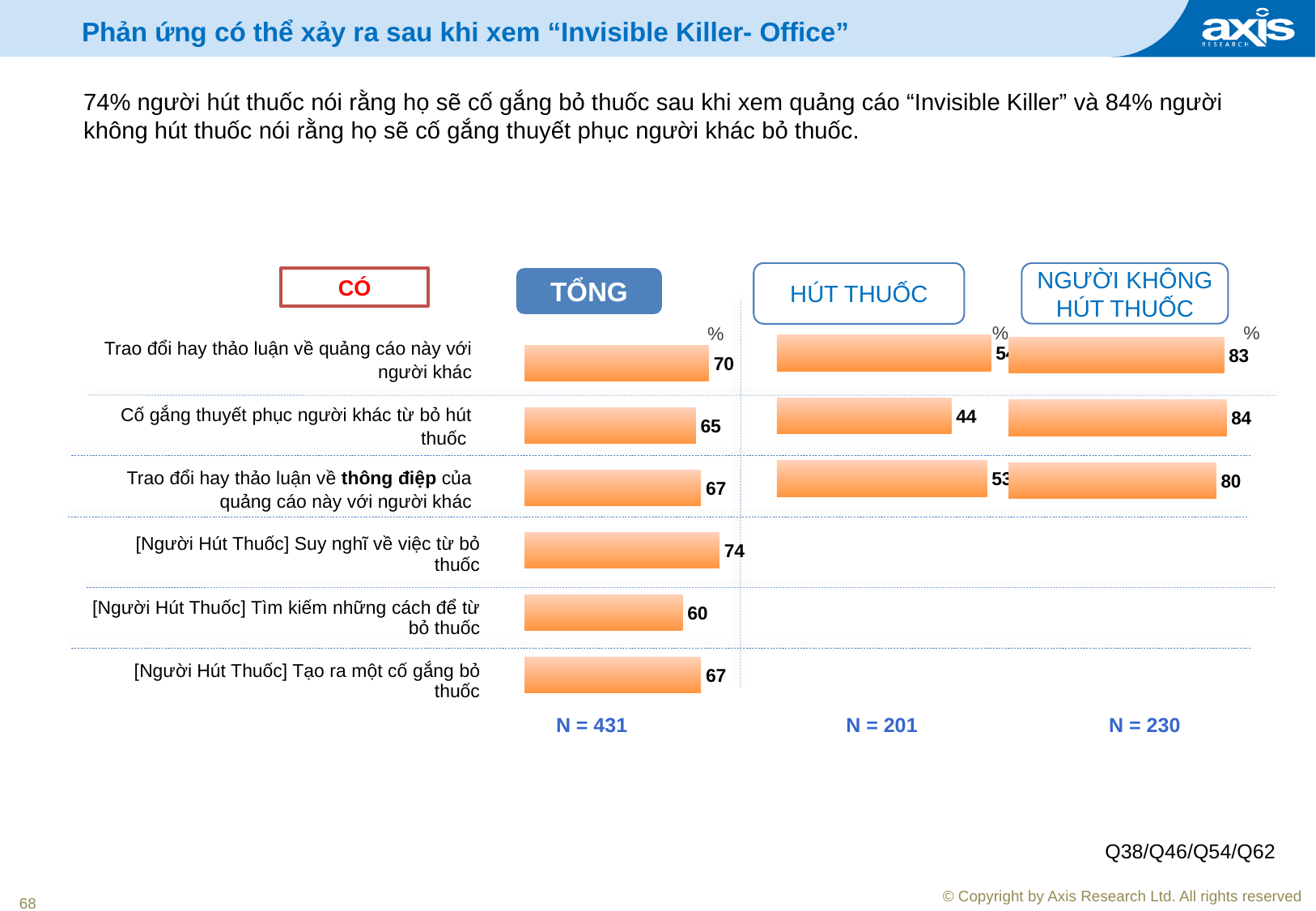
In the NGƯỜI KHÔNG HÚT THUỐC chart, which category has the highest value? Cố gắng thuyết phục người khác từ bỏ hút thuốc In the TỔNG chart, what is the value for "[Người Hút Thuốc] Suy nghĩ về việc từ bỏ thuốc"? 74 In the TỔNG chart, which category has the highest value? [Người Hút Thuốc] Suy nghĩ về việc từ bỏ thuốc For "Cố gắng thuyết phục người khác từ bỏ hút thuốc", which is larger: the HÚT THUỐC value or the NGƯỜI KHÔNG HÚT THUỐC value? NGƯỜI KHÔNG HÚT THUỐC What is the difference between the NGƯỜI KHÔNG HÚT THUỐC value and the HÚT THUỐC value for "Cố gắng thuyết phục người khác từ bỏ hút thuốc"? 40 In the TỔNG chart, which category has the lowest value? [Người Hút Thuốc] Tìm kiếm những cách để từ bỏ thuốc In the TỔNG chart, what is the value for "Cố gắng thuyết phục người khác từ bỏ hút thuốc"? 65 What kind of chart is the TỔNG chart? Bar chart In the HÚT THUỐC chart, what is the value for "Cố gắng thuyết phục người khác từ bỏ hút thuốc"? 44 How many categories are plotted in the TỔNG chart? 6 How many categories are plotted in the HÚT THUỐC chart? 3 In the NGƯỜI KHÔNG HÚT THUỐC chart, what is the value for "Trao đổi hay thảo luận về quảng cáo này với người khác"? 83